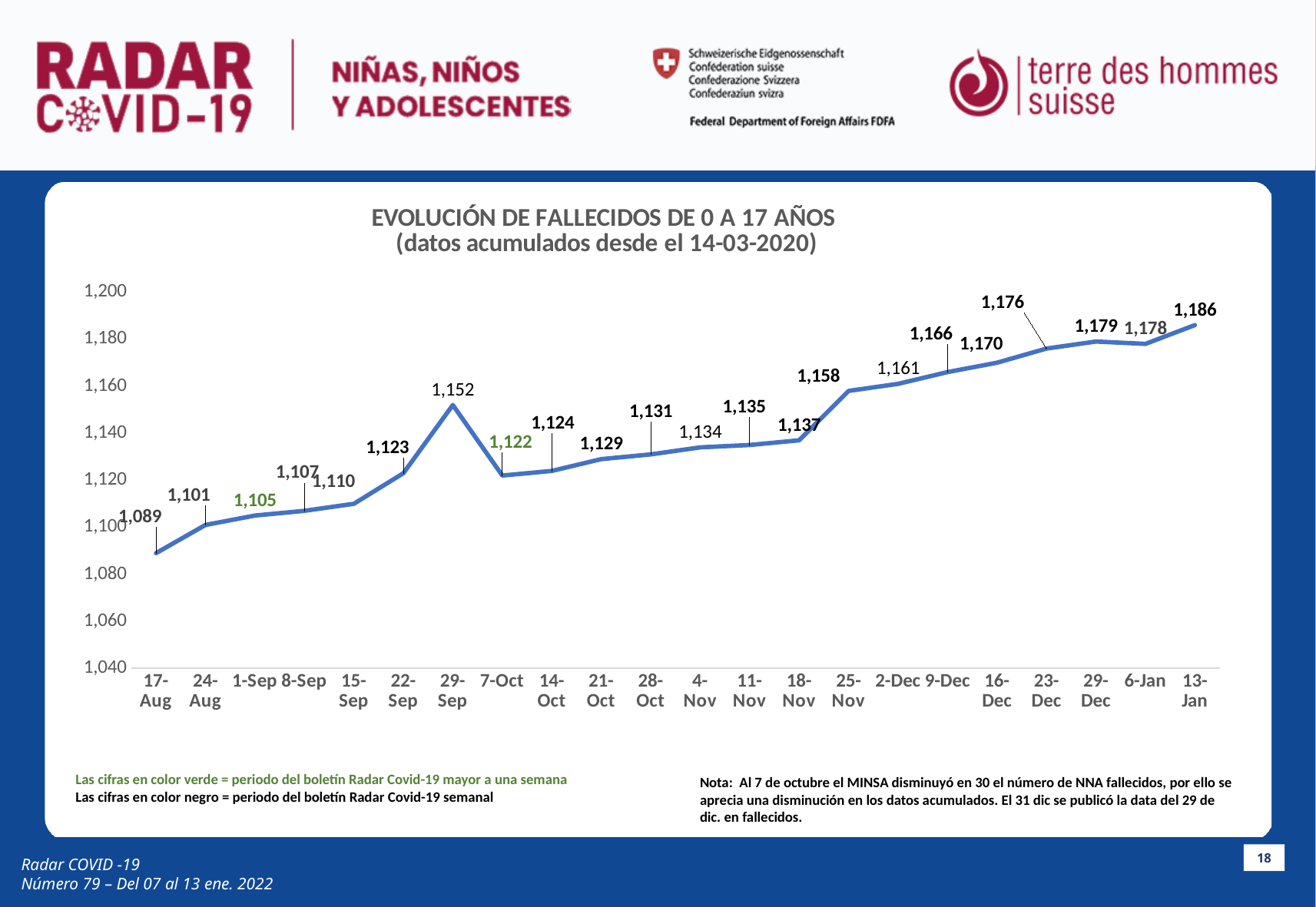
Which date has the lowest value on the chart? 17-Aug What is the difference between the values for 29-Sep and 7-Oct? 30 What is the cumulative number of deaths aged 0 to 17 shown for 13-Jan? 1,186 What is the difference between the values for 13-Jan and 17-Aug? 97 What value is shown for 7-Oct? 1,122 What type of chart is shown on the slide? Line chart What is the title of the chart? EVOLUCIÓN DE FALLECIDOS DE 0 A 17 AÑOS (datos acumulados desde el 14-03-2020) What value is shown for 25-Nov? 1,158 What value is shown for 29-Sep? 1,152 Which date has the highest value on the chart? 13-Jan Which is larger, the value for 29-Dec or the value for 6-Jan? 29-Dec How many data points are plotted on the chart? 22